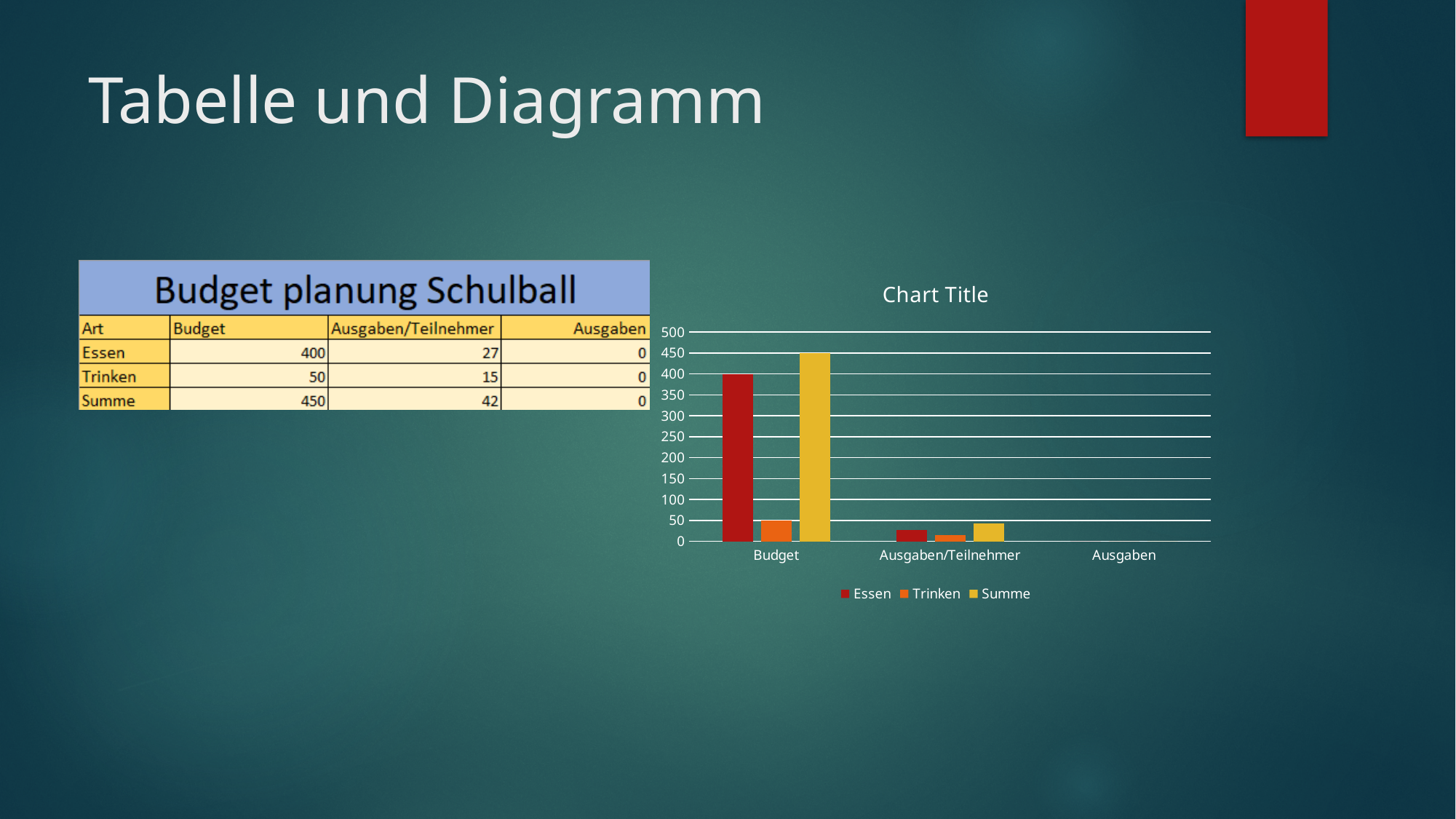
How many categories are shown on the x axis of the chart? 3 What is the title of the chart? Chart Title Which series has the highest bar in the Budget category? Summe Which is larger for Ausgaben/Teilnehmer, the Essen bar or the Trinken bar? Essen What is the value of the Summe bar for Budget in the chart? 450 What is the value of the Trinken bar for Budget in the chart? 50 How many series does the chart legend list? 3 What is the difference between the Summe and Essen bars for Budget? 50 Is the Summe value for Ausgaben/Teilnehmer greater or less than 50? less Which series has the lowest bar in the Budget category? Trinken What kind of chart is shown on the slide? bar chart What is the value of the Essen bar for Budget in the chart? 400